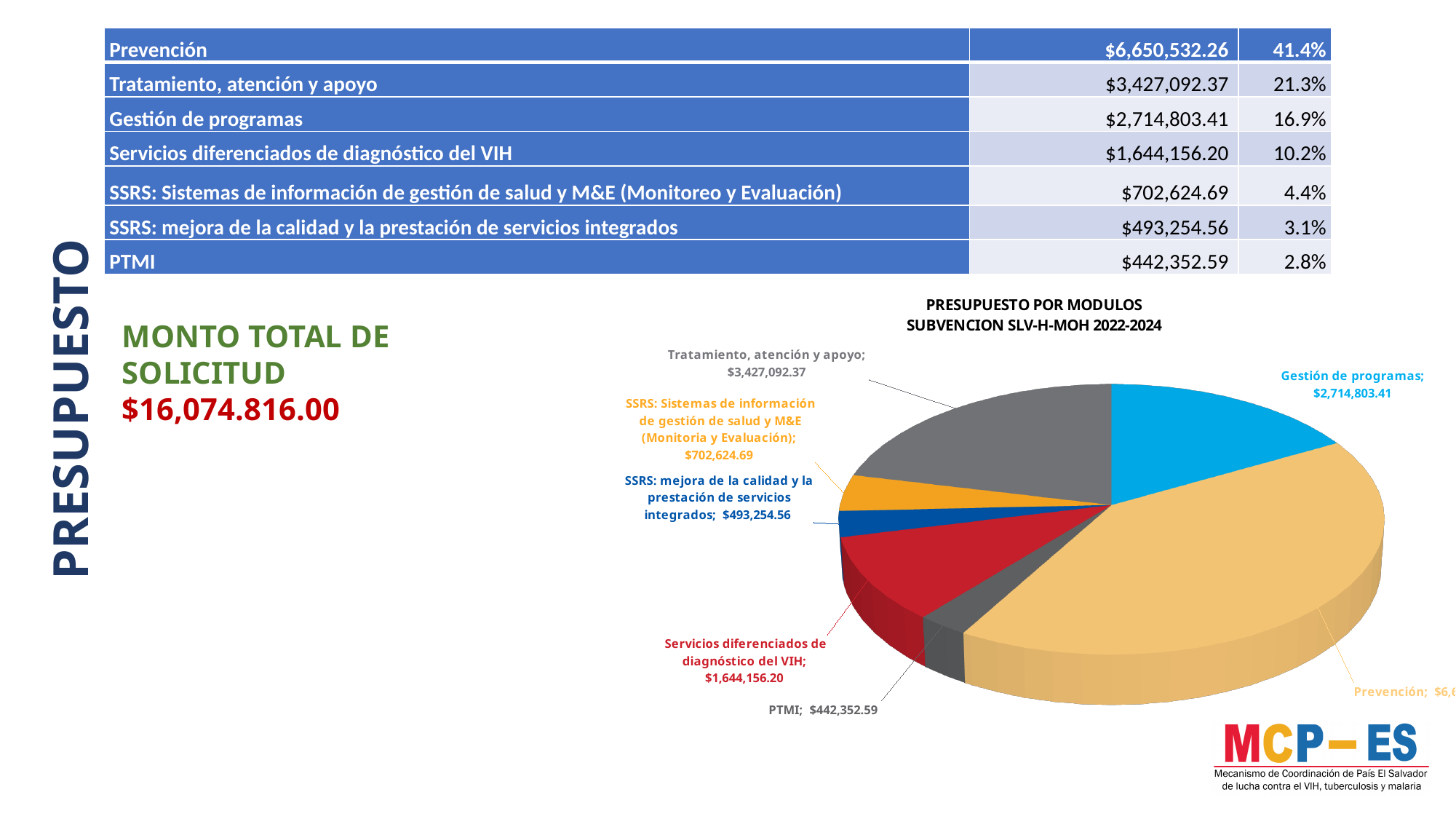
What is the value shown for SSRS: mejora de la calidad y la prestación de servicios integrados in the pie chart? $493,254.56 What is the value shown for Servicios diferenciados de diagnóstico del VIH in the pie chart? $1,644,156.20 What is the value shown for Gestión de programas in the pie chart? $2,714,803.41 Which category has the smallest slice in the pie chart? PTMI How many slices does the pie chart have? 7 What is the value shown for PTMI in the pie chart? $442,352.59 What is the title of the pie chart? PRESUPUESTO POR MODULOS SUBVENCION SLV-H-MOH 2022-2024 What share of the pie does Prevención represent, according to the table on the slide? 41.4% What kind of chart is shown on the slide? pie chart What is the difference between the values for Tratamiento, atención y apoyo and Gestión de programas in the pie chart? $712,288.96 Which category has the largest slice in the pie chart? Prevención Which is larger in the pie chart, Tratamiento, atención y apoyo or Gestión de programas? Tratamiento, atención y apoyo